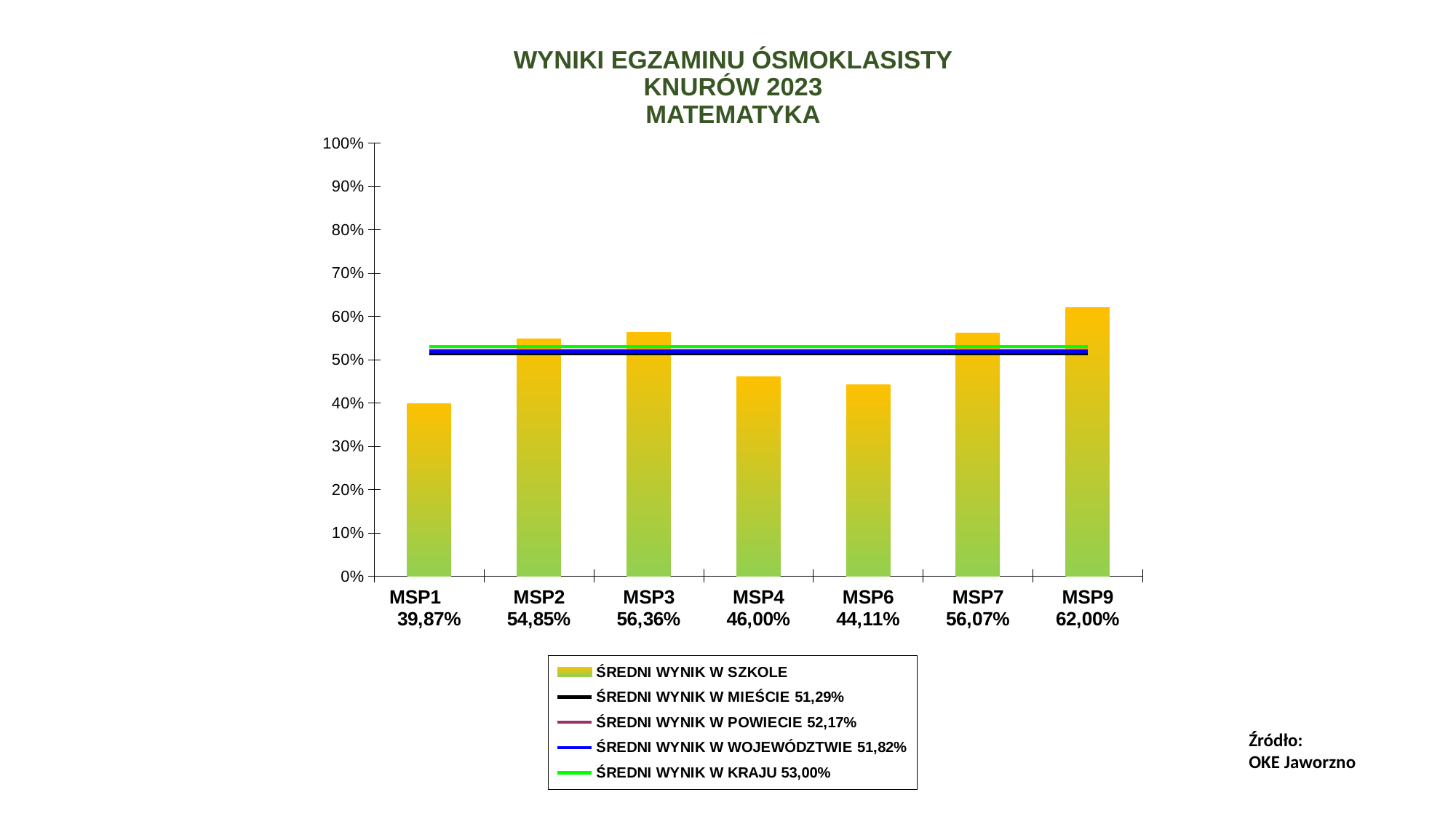
What is the difference between the values for MSP9 and MSP1? 22,13% What is the value for MSP7? 56,07% What subject is named in the chart title? MATEMATYKA How many series does the legend list? 5 Which is larger, the value for MSP2 or the value for MSP4? MSP2 According to the legend, what is the national average result (ŚREDNI WYNIK W KRAJU)? 53,00% Which school has the lowest average result? MSP1 Which school has the highest average result? MSP9 What kind of chart is shown on the slide? combination bar and line chart How many schools (bars) are shown on the chart? 7 Is the value for MSP6 greater or less than 50%? less What is the value for MSP1? 39,87%